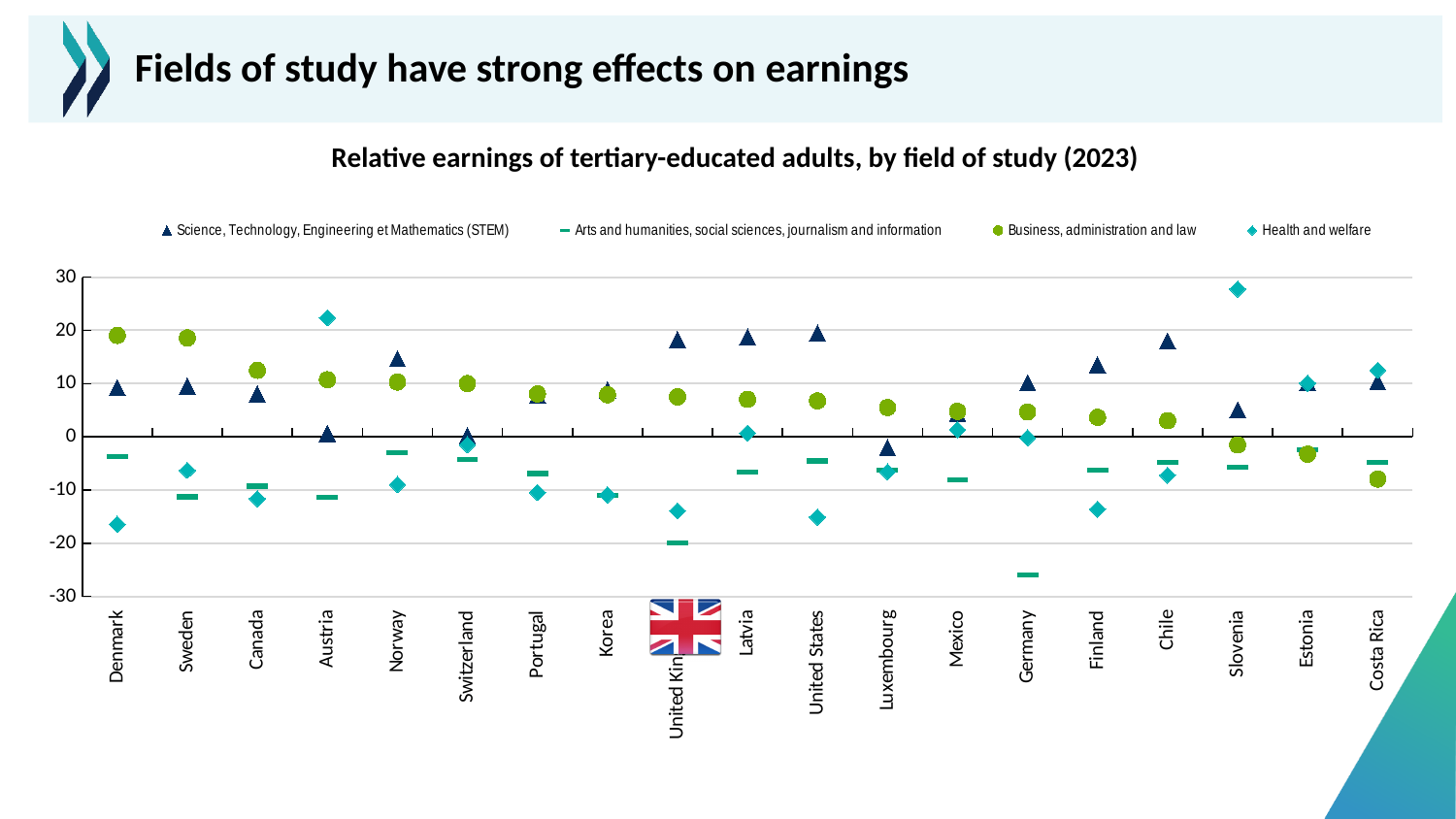
Is the Health and welfare value for Denmark greater or less than -10? less Which country has the highest value for Health and welfare? Slovenia Is the Business, administration and law value for Denmark greater or less than 10? greater Which marker shape represents the Health and welfare series? Diamond Is the Arts and humanities, social sciences, journalism and information value for Germany greater or less than -20? less How many countries are shown on the x axis? 19 For Austria, which is larger: the Health and welfare value or the STEM value? Health and welfare What is the title of the chart? Relative earnings of tertiary-educated adults, by field of study (2023) How many series does the legend list? 4 Which country has the lowest value for Arts and humanities, social sciences, journalism and information? Germany For Denmark, which is larger: the Business, administration and law value or the STEM value? Business, administration and law